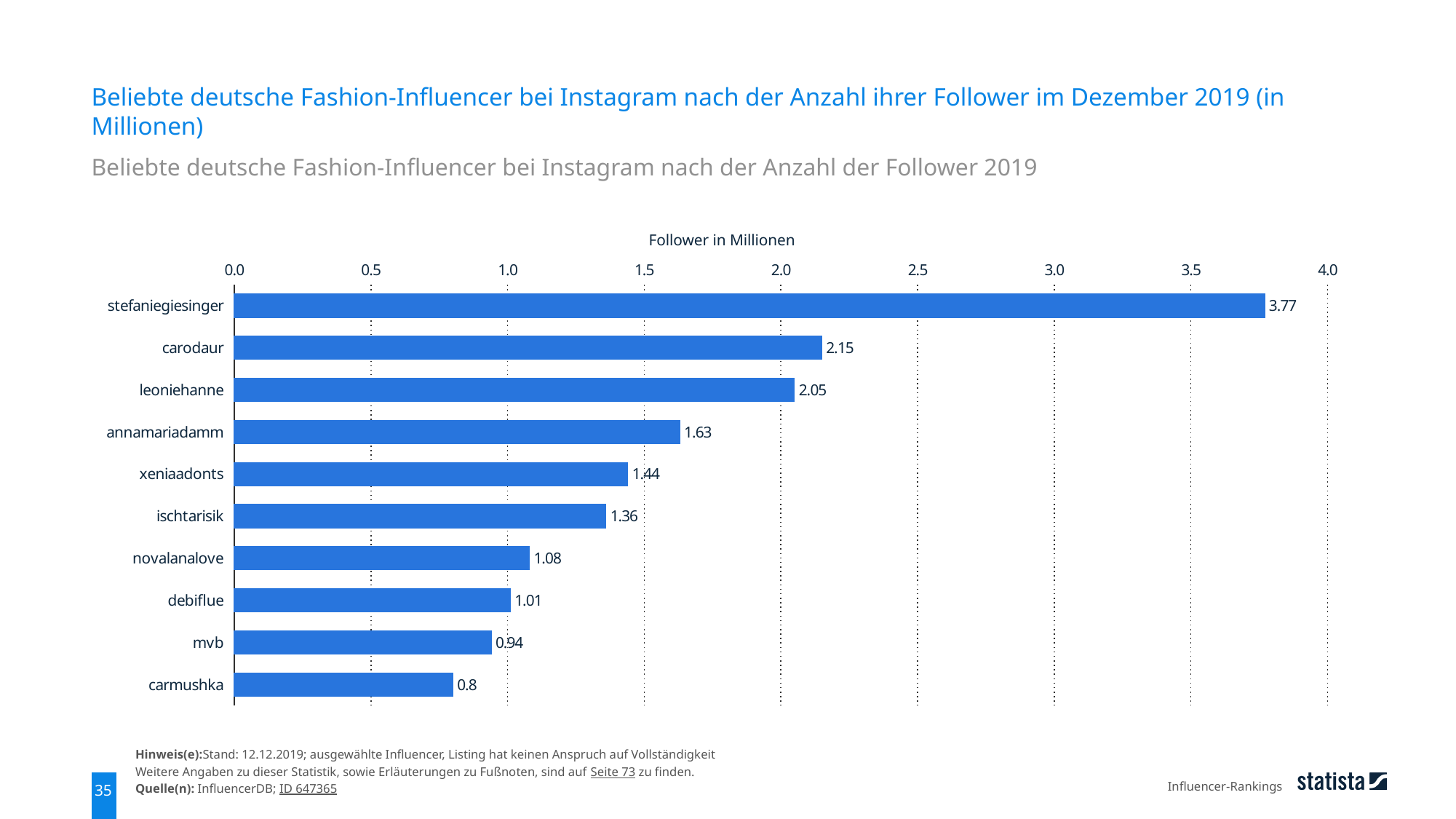
What is the difference in followers (in millions) between stefaniegiesinger and carodaur? 1.62 How many followers (in millions) does stefaniegiesinger have? 3.77 What is the difference in followers (in millions) between carodaur and leoniehanne? 0.1 How many influencers are shown in the chart? 10 Which influencer has the highest number of followers? stefaniegiesinger Who has more followers, annamariadamm or xeniaadonts? annamariadamm What is the value shown for leoniehanne? 2.05 What is the value shown for carmushka? 0.8 Which influencer has the lowest number of followers? carmushka Is the value for ischtarisik greater or less than 1.5? less What kind of chart is shown on the slide? bar chart What is the label of the value axis? Follower in Millionen